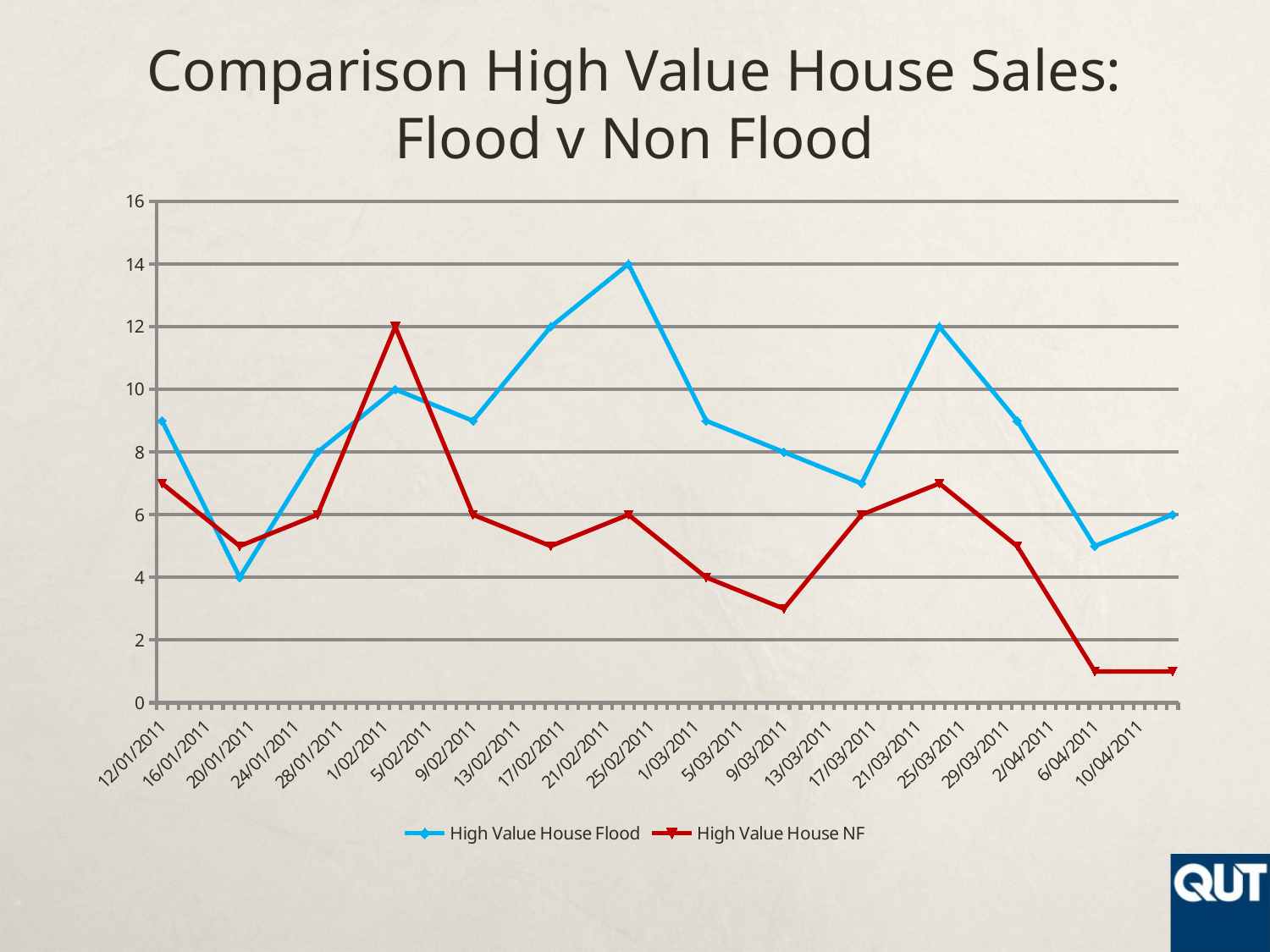
What is the difference between the peak value of the High Value House Flood series (14) and the peak value of the High Value House NF series (12)? 2 How many series does the legend list? 2 What is the highest value reached by the High Value House NF series? 12 Is the first plotted value of the High Value House Flood series greater or less than 8? greater What is the highest value reached by the High Value House Flood series? 14 Which series is plotted in red? High Value House NF What is the lowest value reached by the High Value House Flood series? 4 Is the lowest value of the High Value House NF series greater or less than 2? less What are the two series named in the legend? High Value House Flood and High Value House NF Which series reaches the higher peak value, High Value House Flood or High Value House NF? High Value House Flood Does the High Value House NF series rise or fall over its last four points? fall What kind of chart is shown on the slide? line chart